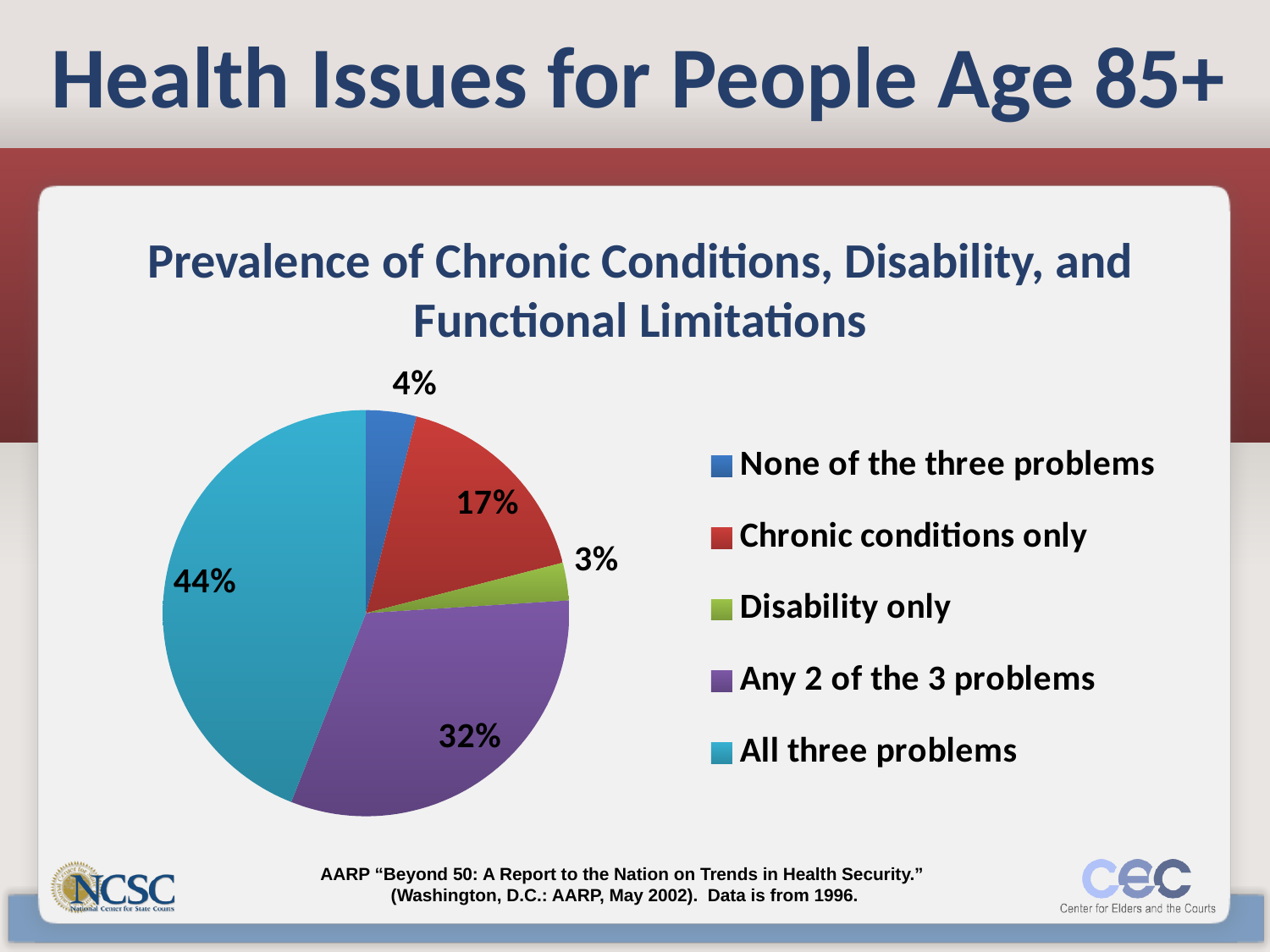
How many categories does the pie chart show? 5 Which is larger: the share for 'Chronic conditions only' or the share for 'None of the three problems'? Chronic conditions only Which category has the largest share of the pie? All three problems What is the title of the chart? Prevalence of Chronic Conditions, Disability, and Functional Limitations What percentage of people age 85+ have all three problems? 44% What is the difference in percentage points between 'All three problems' and 'Any 2 of the 3 problems'? 12 What percentage of people age 85+ have chronic conditions only? 17% What kind of chart is shown on the slide? Pie chart What percentage of people age 85+ have disability only? 3% What percentage of people age 85+ have none of the three problems? 4% What percentage of people age 85+ have any 2 of the 3 problems? 32% Which category has the smallest share of the pie? Disability only